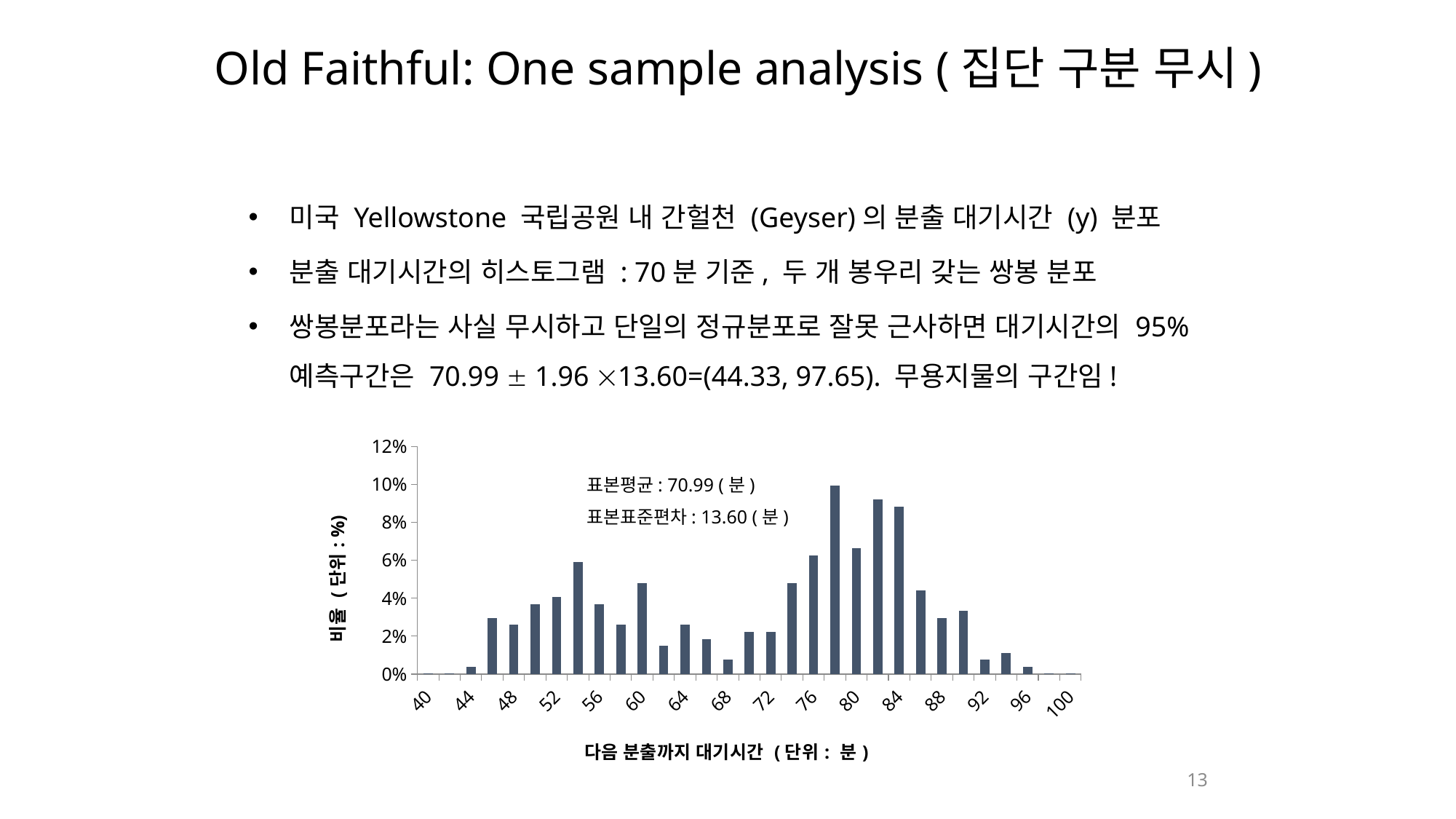
Is the value of the bar at 60 on the x axis greater or less than 4%? greater Which bar is taller, the one at 60 or the one at 68 on the x axis? 60 Is the value of the bar at 84 on the x axis greater or less than 8%? greater What is the sample standard deviation (표본표준편차) printed on the chart? 13.60 ( 분 ) Is the value of the bar at 96 on the x axis greater or less than 2%? less How many tick labels are shown on the x axis? 16 What kind of chart is shown on the slide? bar chart Which bar is taller, the one at 84 or the one at 52 on the x axis? 84 What is the sample mean (표본평균) printed on the chart? 70.99 ( 분 )